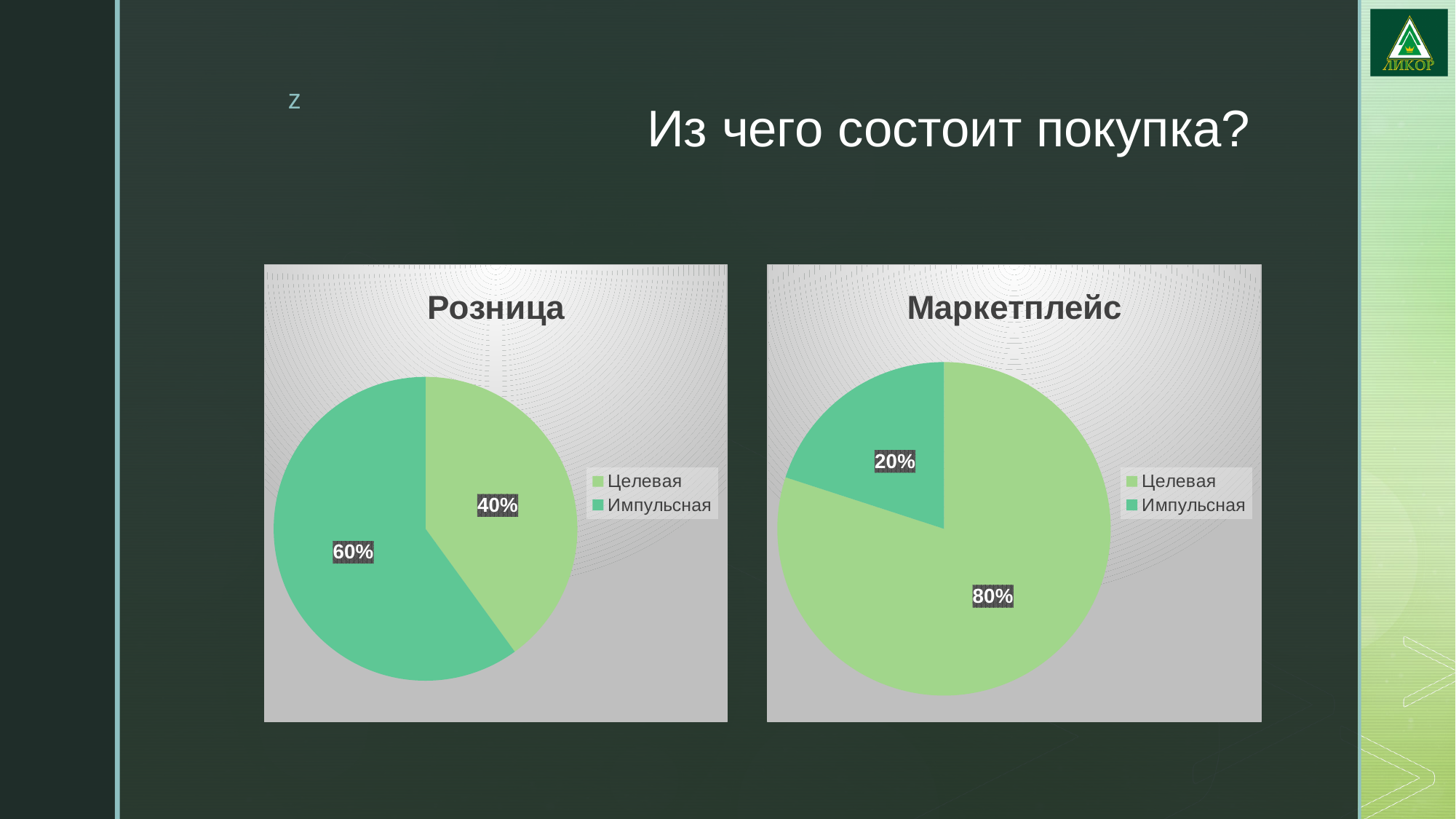
What is the title of the chart on the left side of the slide? Розница How many entries does the legend of the 'Маркетплейс' chart list? 2 In the 'Маркетплейс' chart, what is the difference between Целевая and Импульсная? 60% In the 'Маркетплейс' chart, what is the value for Целевая? 80% In the 'Розница' chart, what is the value for Целевая? 40% In the 'Розница' chart, which category has the largest slice? Импульсная In the 'Маркетплейс' chart, what is the value for Импульсная? 20% In the 'Маркетплейс' chart, which category has the smallest slice? Импульсная In the 'Розница' chart, which is larger: Целевая or Импульсная? Импульсная In the 'Розница' chart, what is the value for Импульсная? 60% What kind of chart is the 'Маркетплейс' chart? Pie chart How many slices does the 'Розница' chart have? 2